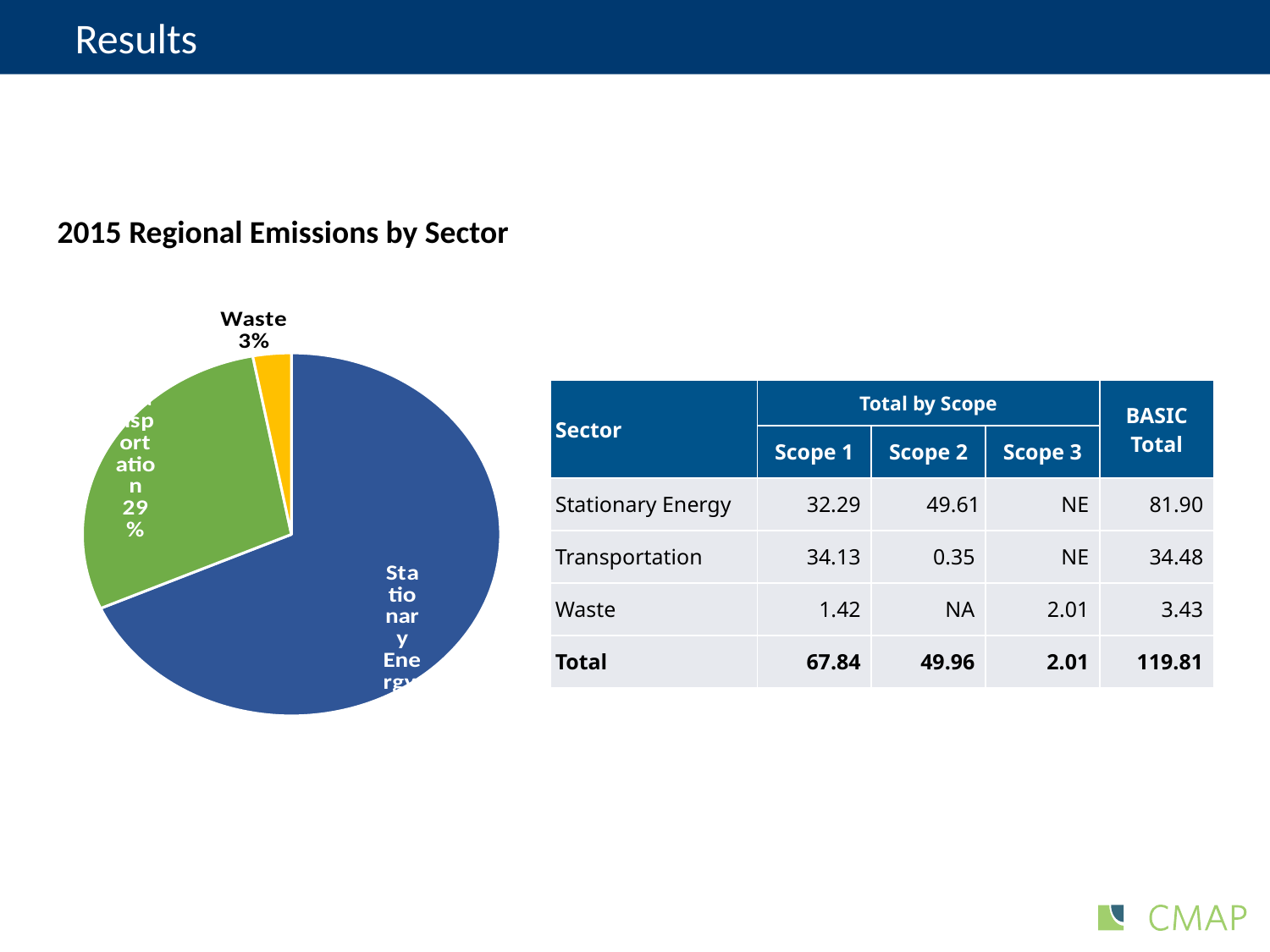
What is the title of the chart? 2015 Regional Emissions by Sector By how many percentage points does the Transportation share exceed the Waste share? 26 Which sector has the smallest slice of the pie chart? Waste What share of the pie does Transportation account for? 29% How many slices does the pie chart have? 3 Which slice is larger, Stationary Energy or Transportation? Stationary Energy Which slice is larger, Transportation or Waste? Transportation What kind of chart is shown on the slide? Pie chart Which sector has the largest slice of the pie chart? Stationary Energy What share of the pie does Waste account for? 3% What colour is the Waste slice of the pie chart? Yellow